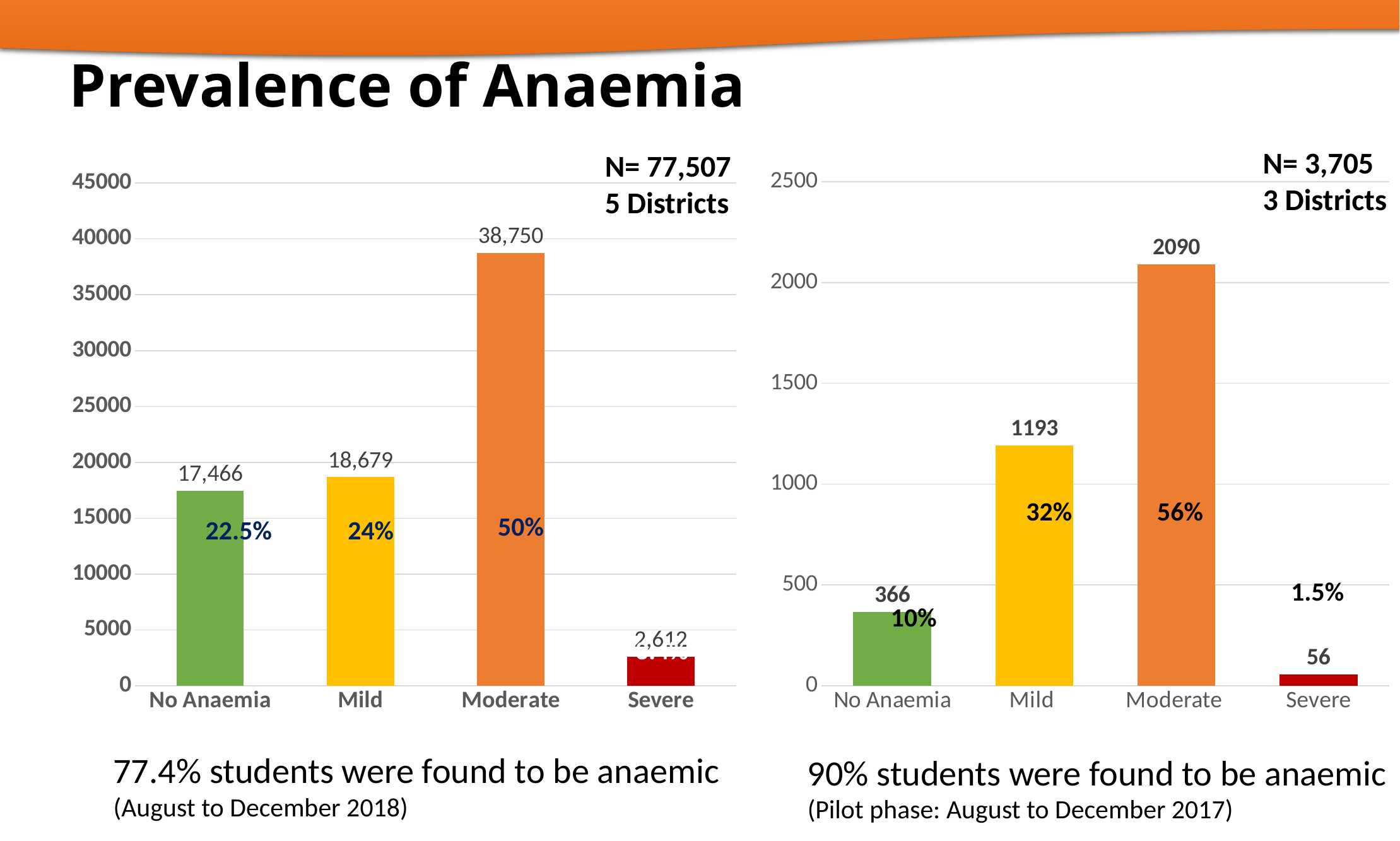
In the right chart (N= 3,705, 3 Districts), what is the value for Severe? 56 In the right chart (N= 3,705, 3 Districts), which is larger, the value for No Anaemia or the value for Mild? Mild In the left chart (N= 77,507, 5 Districts), is the value for Severe greater or less than 5000? less In the right chart (N= 3,705, 3 Districts), what is the difference between the Moderate and Mild values? 897 In the left chart (N= 77,507, 5 Districts), which category has the highest value? Moderate In the right chart (N= 3,705, 3 Districts), what is the value for Mild? 1193 What kind of chart is the left chart (N= 77,507, 5 Districts)? bar chart In the left chart (N= 77,507, 5 Districts), what is the value for No Anaemia? 17,466 In the left chart (N= 77,507, 5 Districts), what is the value for Moderate? 38,750 How many categories are shown on the x axis of the right chart (N= 3,705, 3 Districts)? 4 In the right chart (N= 3,705, 3 Districts), which category has the lowest value? Severe In the left chart (N= 77,507, 5 Districts), what is the difference between the Mild and No Anaemia values? 1,213